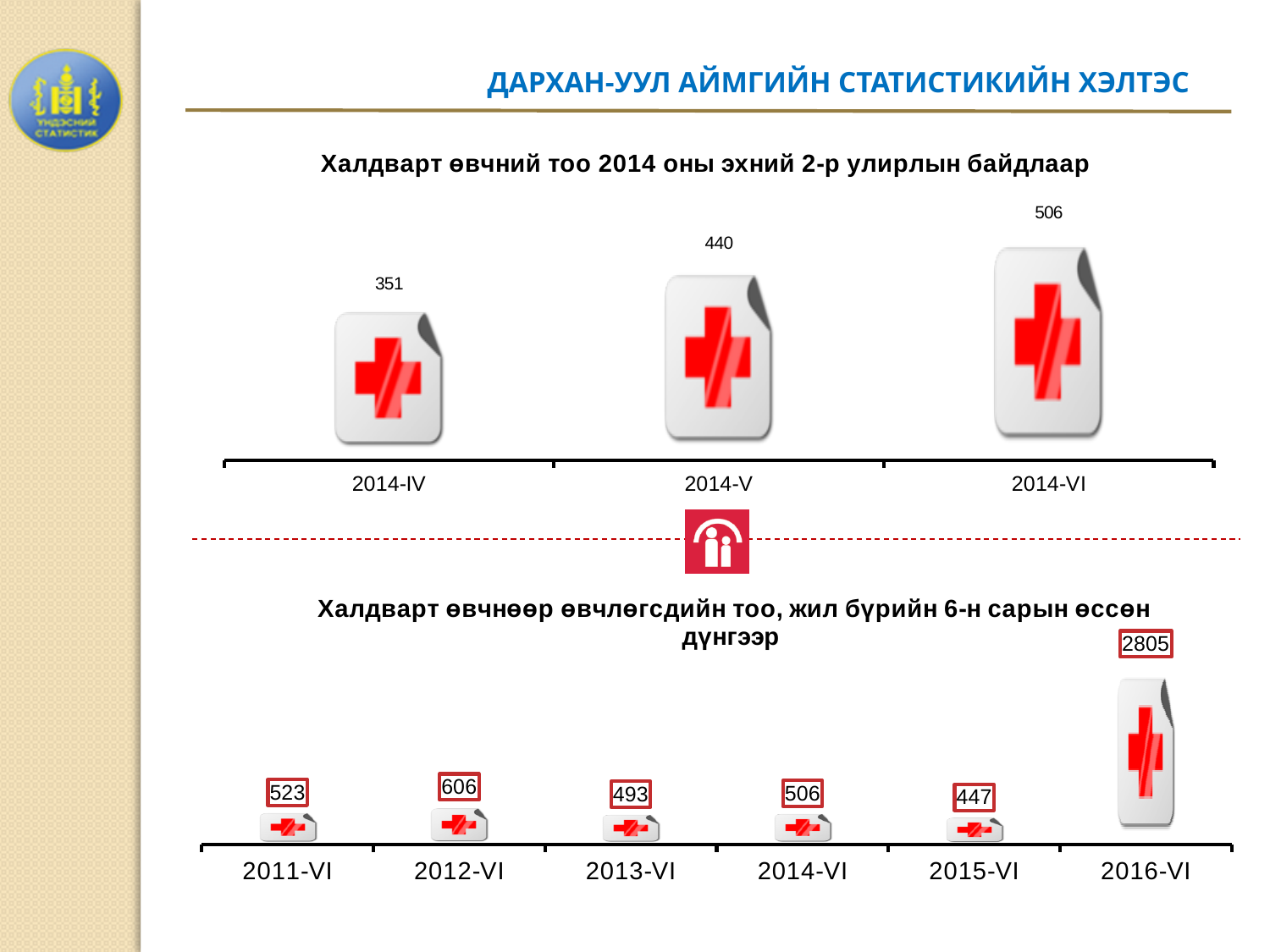
In the bottom chart, what is the value for 2016-VI? 2805 In the top chart, do the values rise or fall from 2014-IV to 2014-VI? rise In the bottom chart, what is the difference between the values for 2012-VI and 2015-VI? 159 In the bottom chart, which is larger, the value for 2011-VI or 2013-VI? 2011-VI In the top chart, what is the difference between the values for 2014-VI and 2014-IV? 155 In the top chart, which month has the highest value? 2014-VI In the top chart, how many months are shown? 3 In the bottom chart, what is the value for 2012-VI? 606 In the bottom chart, how many years are shown? 6 In the top chart, what is the value for 2014-IV? 351 In the top chart, what is the value for 2014-V? 440 In the bottom chart, which year has the lowest value? 2015-VI